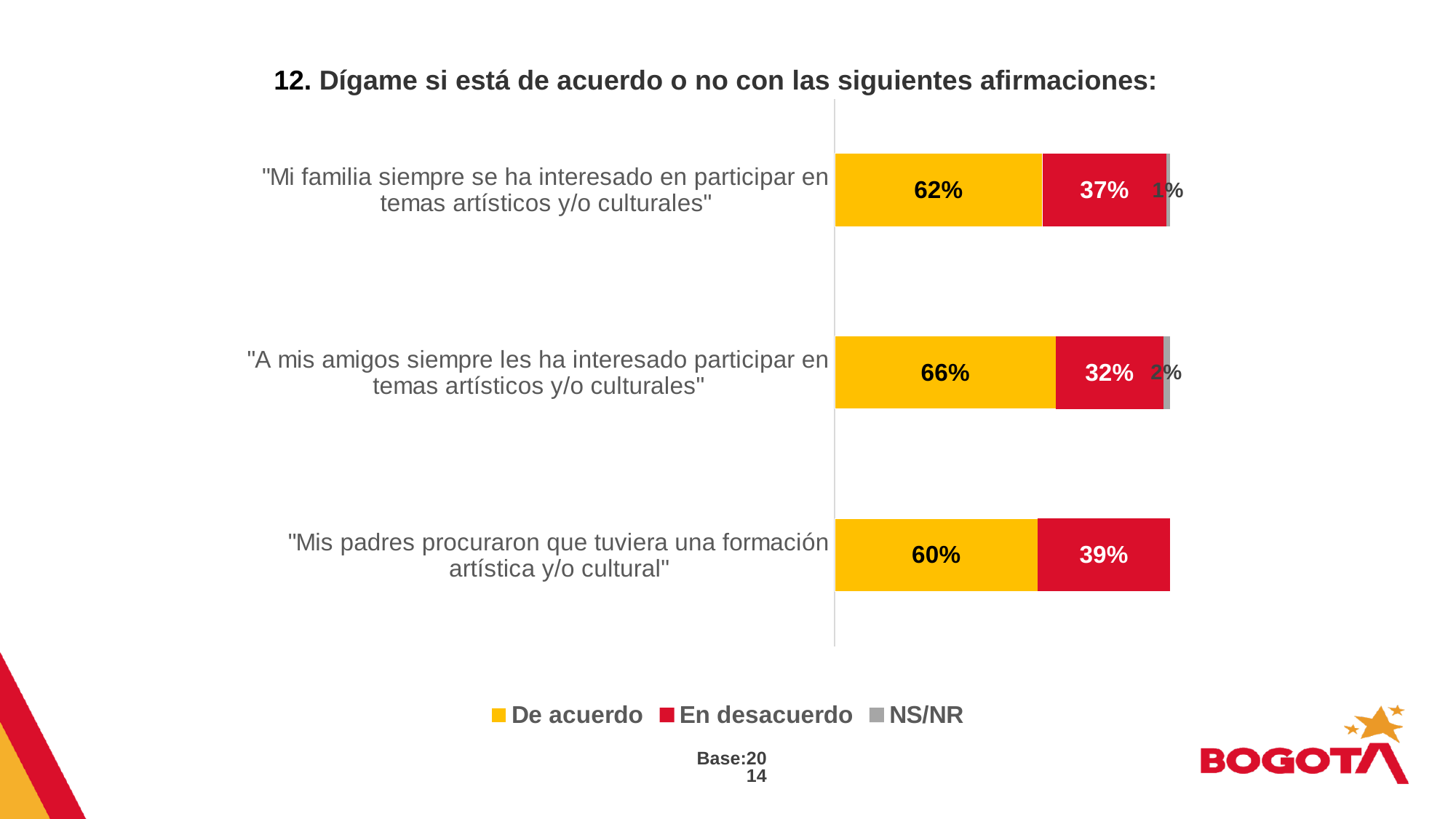
What kind of chart is shown on the slide? Stacked bar chart Which is larger: the "En desacuerdo" value for "Mi familia siempre se ha interesado en participar en temas artísticos y/o culturales" or for "Mis padres procuraron que tuviera una formación artística y/o cultural"? "Mis padres procuraron que tuviera una formación artística y/o cultural" What percentage of respondents are "De acuerdo" with "Mi familia siempre se ha interesado en participar en temas artísticos y/o culturales"? 62% What percentage of respondents are "En desacuerdo" with "A mis amigos siempre les ha interesado participar en temas artísticos y/o culturales"? 32% How many series does the legend list? 3 How many statements are shown in the chart? 3 Which colour represents "En desacuerdo" in the chart? Red What percentage of respondents are "En desacuerdo" with "Mis padres procuraron que tuviera una formación artística y/o cultural"? 39% Which statement has the highest "De acuerdo" percentage? "A mis amigos siempre les ha interesado participar en temas artísticos y/o culturales" What is the difference between the "De acuerdo" and "En desacuerdo" percentages for "Mi familia siempre se ha interesado en participar en temas artísticos y/o culturales"? 25% Which statement has the lowest "De acuerdo" percentage? "Mis padres procuraron que tuviera una formación artística y/o cultural" What is the "NS/NR" value for "A mis amigos siempre les ha interesado participar en temas artísticos y/o culturales"? 2%